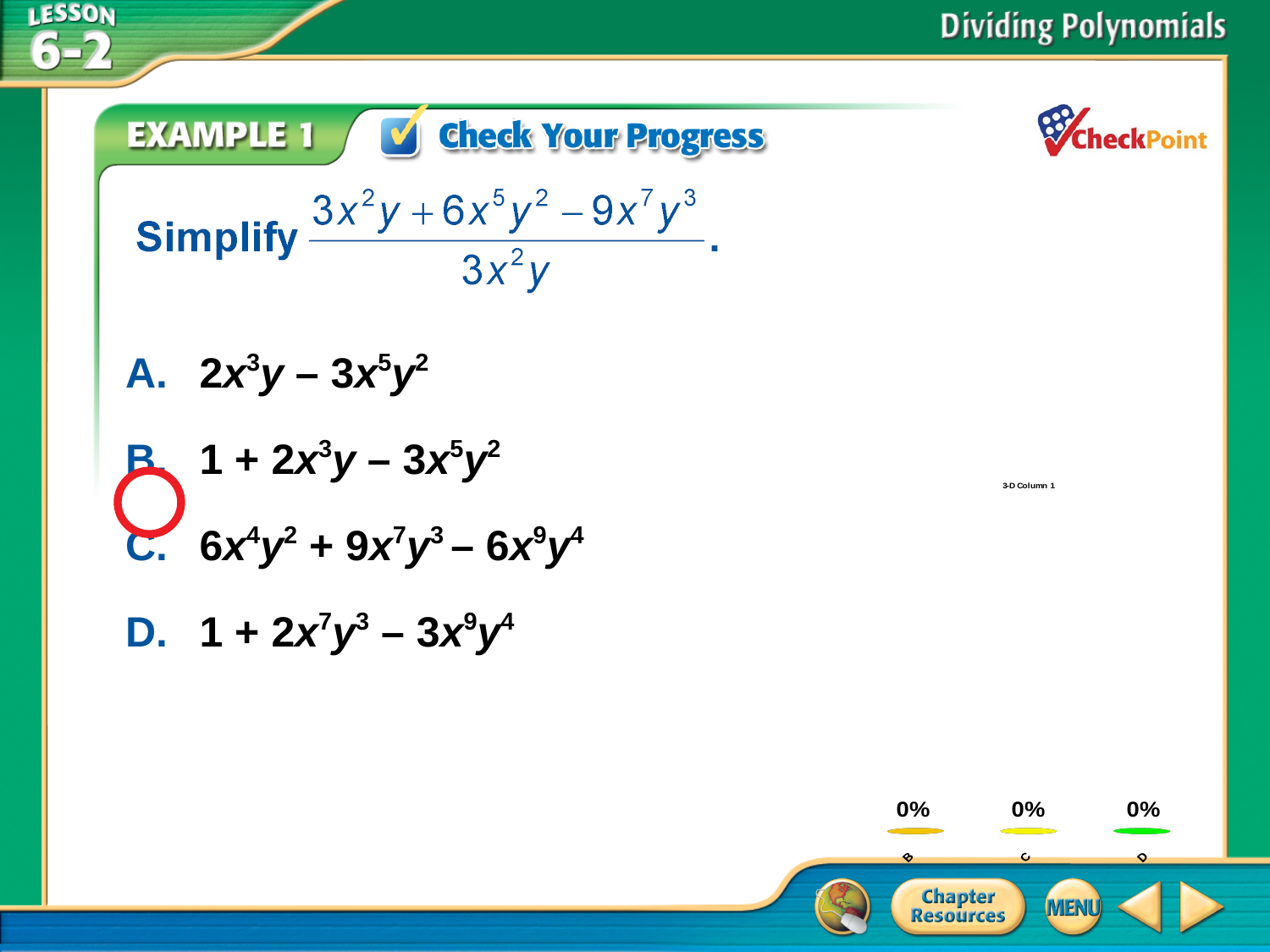
In the chart at the bottom right, what is the difference between the values for B and D? 0% In the chart at the bottom right, what value is shown for category C? 0% In the chart at the bottom right, what colour is the bar for category D? green In the chart at the bottom right, what value is shown for category D? 0% How many categories are shown in the chart at the bottom right of the slide? 3 In the chart at the bottom right, what value is shown for category B? 0% What kind of chart is shown at the bottom right of the slide? bar chart